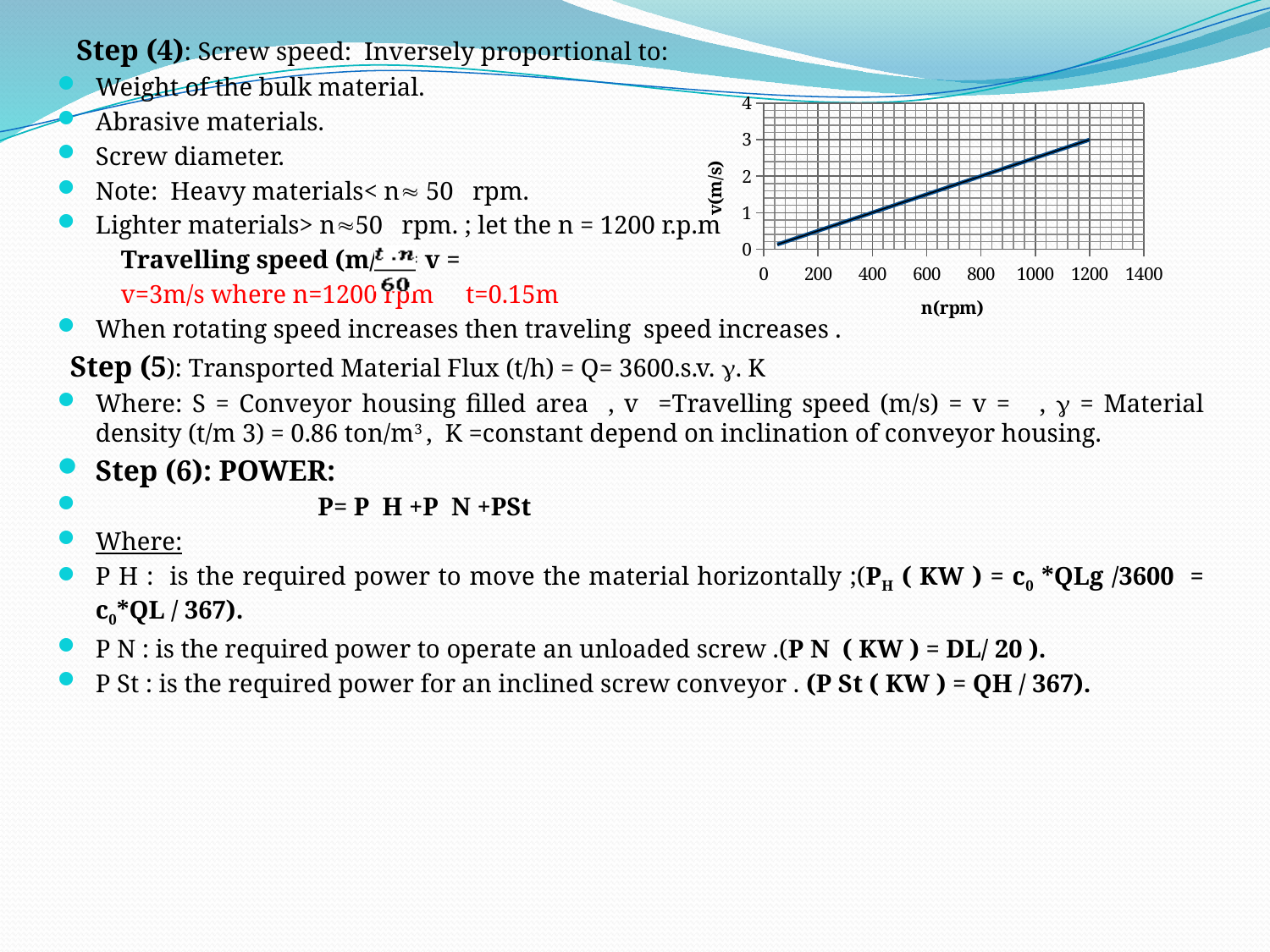
What is the label of the vertical axis of the chart? v(m/s) Is the value of v at n = 600 rpm greater or less than 1? greater Is the value of v at n = 1200 rpm greater or less than 2? greater What kind of chart is shown on the slide? line chart Does the travelling speed v rise or fall as n(rpm) increases along the x axis? rise What is the label of the horizontal axis of the chart? n(rpm) Which has the larger v value on the chart: n = 400 rpm or n = 1000 rpm? n = 1000 rpm Is the value of v at n = 600 rpm greater or less than 2? less